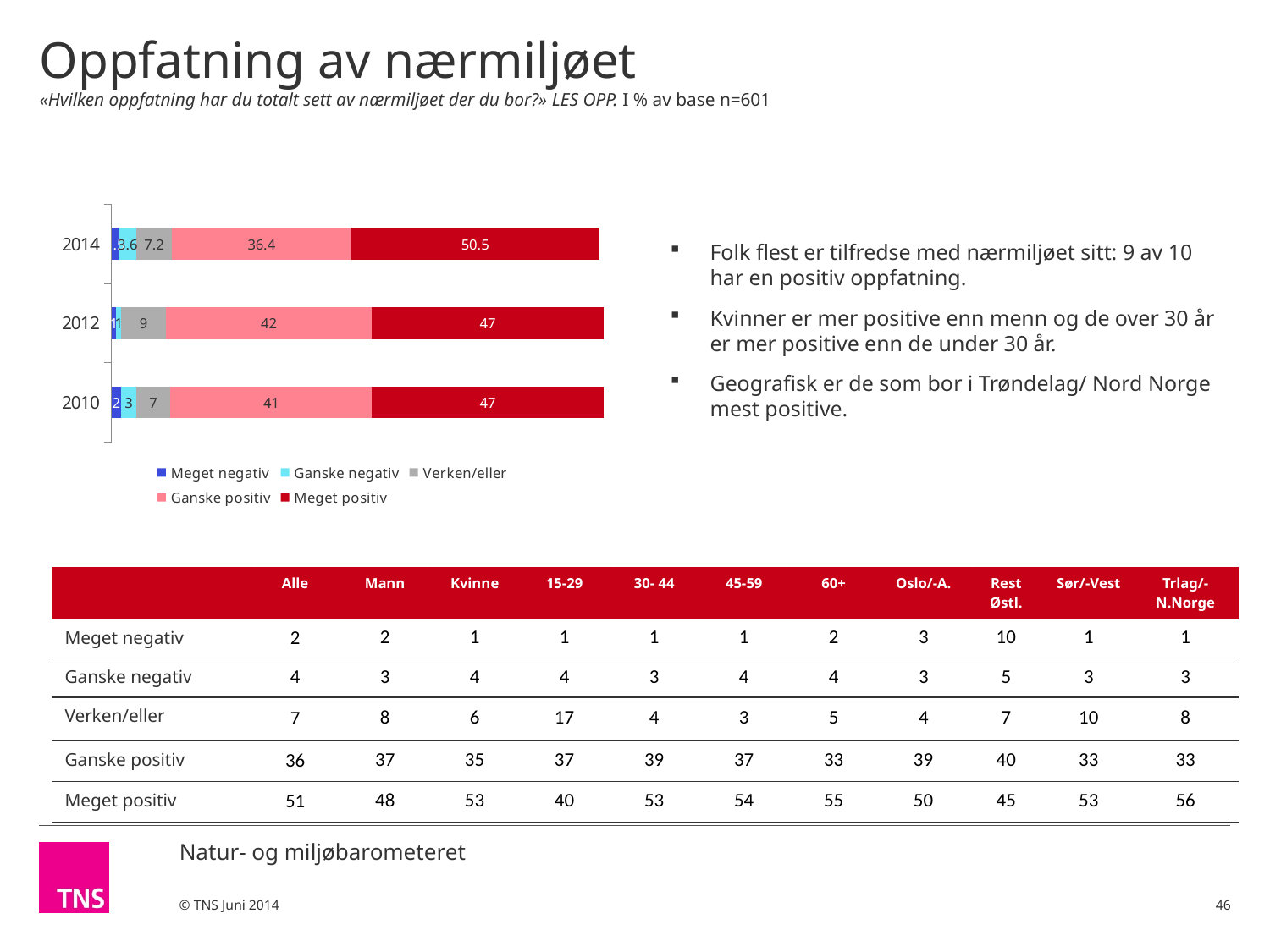
What is the value for Verken/eller in 2010? 7 What is the value for Ganske positiv in 2012? 42 How many years are shown in the chart? 3 What kind of chart is shown on the slide? Stacked bar chart What is the difference between the Meget positiv values for 2014 and 2012? 3.5 What is the difference between the Ganske positiv values for 2012 and 2010? 1 Which is larger, the Ganske positiv value for 2014 or for 2012? 2012 How many series does the legend list? 5 Which year has the highest value for Meget positiv? 2014 What is the value for Meget positiv in 2014? 50.5 What is the value for Verken/eller in 2012? 9 What is the value for Ganske positiv in 2014? 36.4